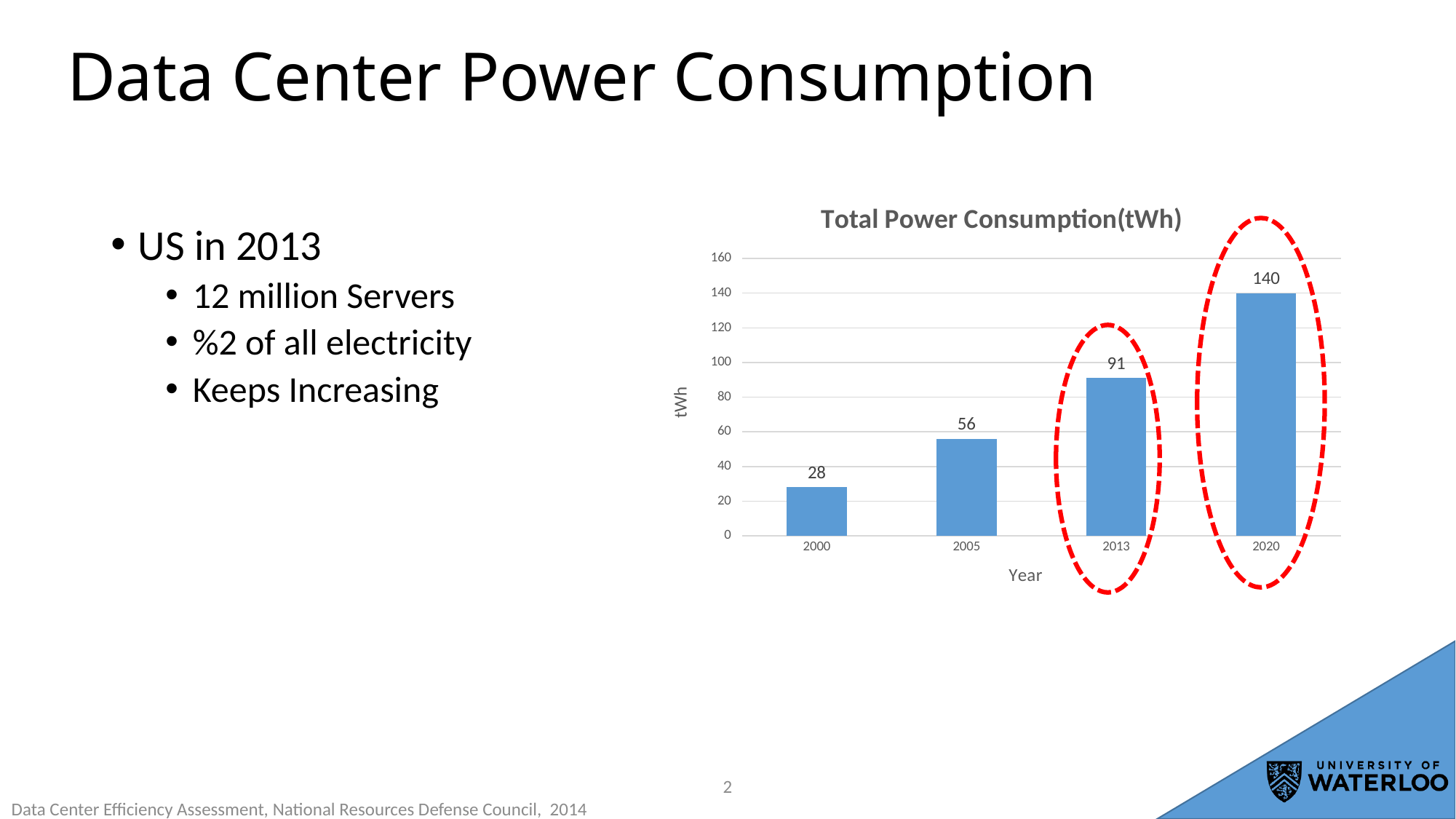
What is the difference between the values for 2005 and 2000? 28 How many years are shown on the x axis of the chart? 4 Do the values rise or fall from 2000 to 2020? Rise What is the difference between the values for 2020 and 2013? 49 What is the total power consumption value shown for 2005? 56 Which year has the highest total power consumption? 2020 Which year has the lowest total power consumption? 2000 What is the total power consumption value shown for 2020? 140 What is the total power consumption value shown for 2000? 28 Which is larger, the value for 2005 or the value for 2013? 2013 What kind of chart is shown on the slide? Bar chart What is the total power consumption value shown for 2013? 91